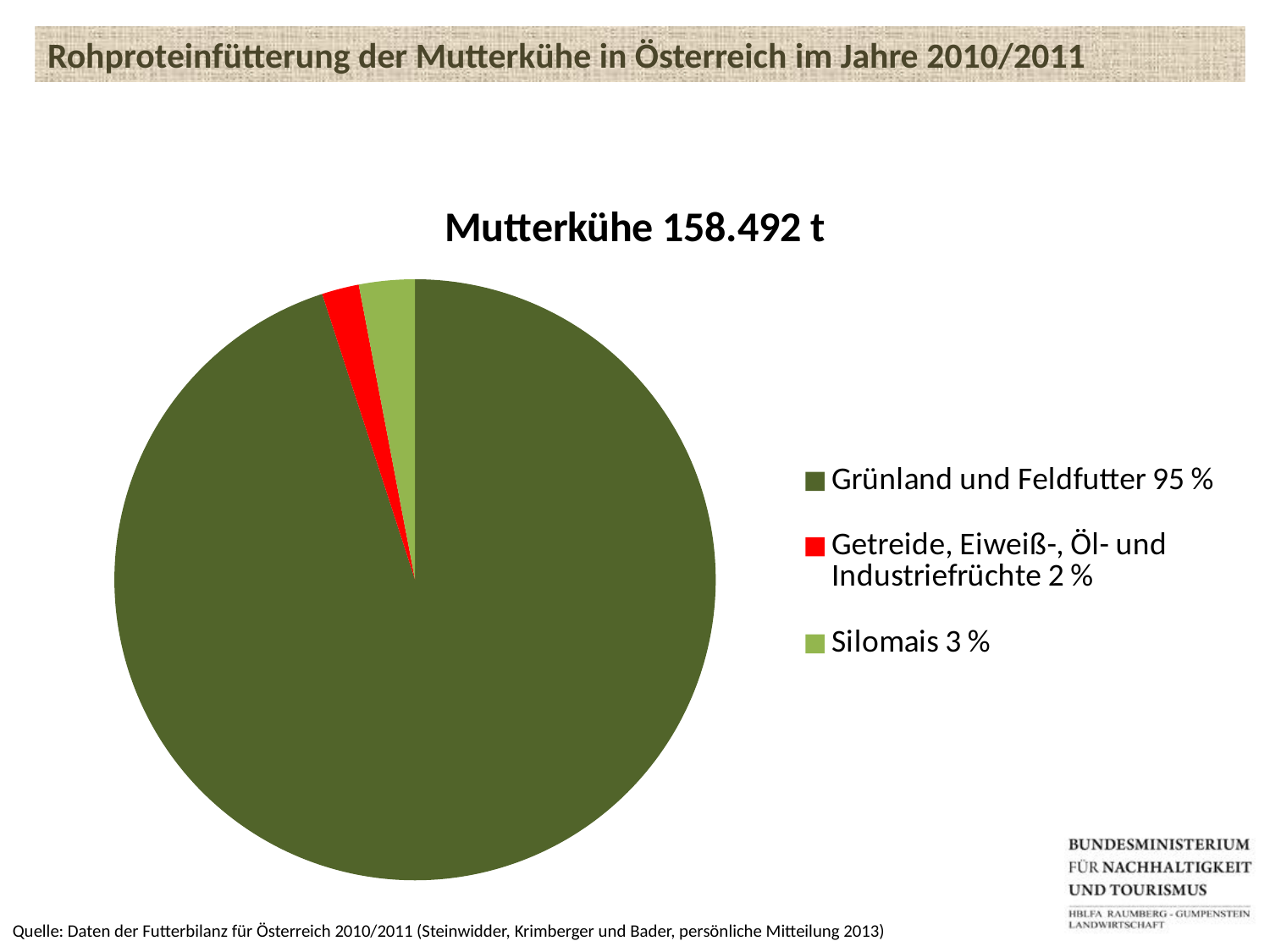
Which category has the largest share of the pie? Grünland und Feldfutter What share of the pie does Silomais represent? 3 % What kind of chart is shown on the slide? pie chart What is the title of the chart? Mutterkühe 158.492 t What is the difference in percentage points between the share for Grünland und Feldfutter and the share for Silomais? 92 percentage points Which is larger, the share for Silomais or the share for Getreide, Eiweiß-, Öl- und Industriefrüchte? Silomais How many slices does the pie chart have? 3 What colour is the slice for Silomais? light green What is the total amount of crude protein shown in the chart title for Mutterkühe? 158.492 t What share of the pie does Getreide, Eiweiß-, Öl- und Industriefrüchte represent? 2 % Which category has the smallest share of the pie? Getreide, Eiweiß-, Öl- und Industriefrüchte What share of the pie does Grünland und Feldfutter represent? 95 %